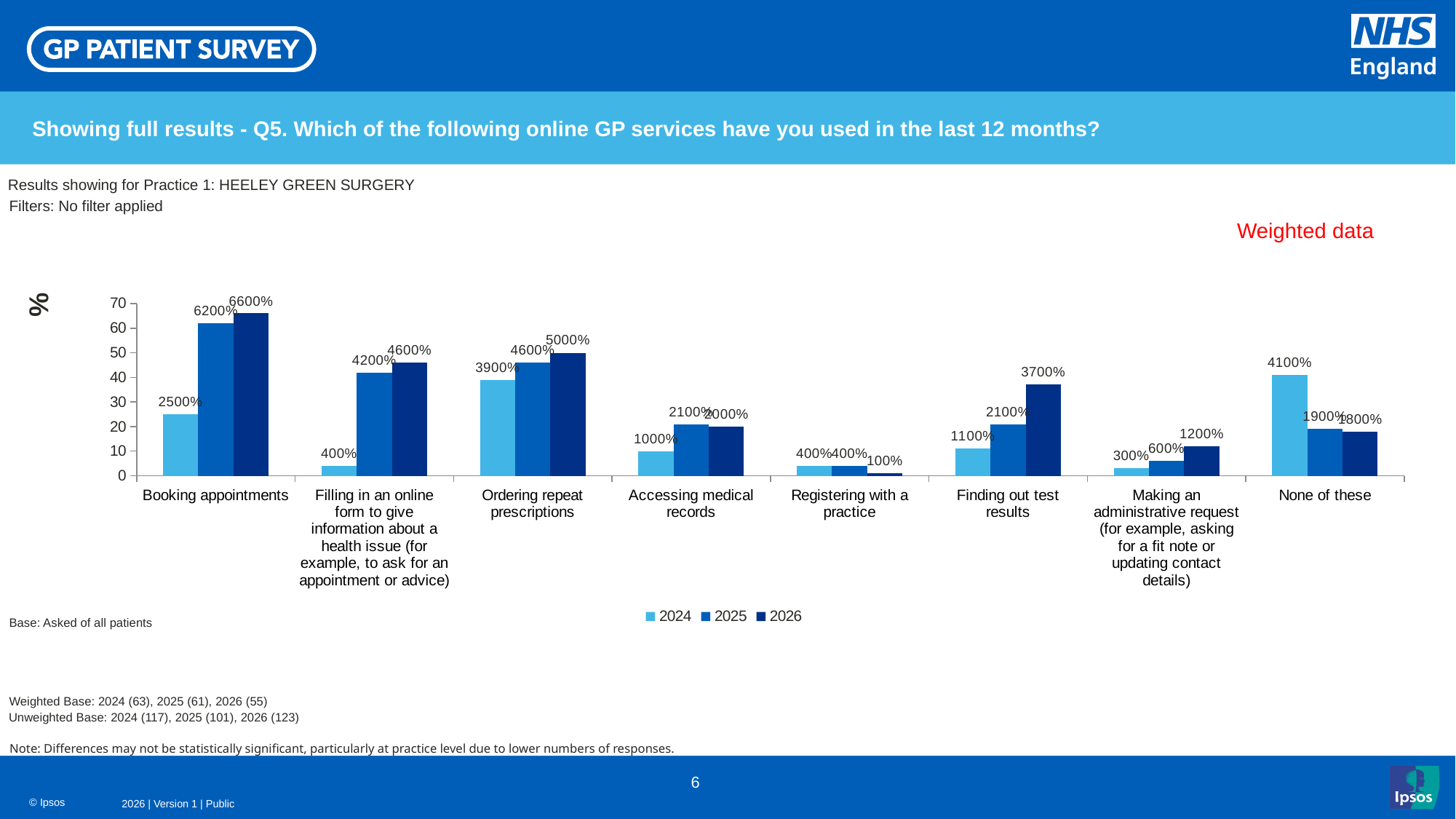
What is the data label for 2026 on the Booking appointments bar? 6600% How many categories are shown on the x axis? 8 Which is larger for None of these: the 2024 value or the 2025 value? 2024 What kind of chart is shown on the slide? bar chart What is the data label for 2024 on the Ordering repeat prescriptions bar? 3900% Is the 2024 bar for Booking appointments greater or less than 30 on the axis? less Do the values for Finding out test results rise or fall from 2024 to 2026? rise Which category has the highest 2026 value? Booking appointments Which category has the lowest 2026 value? Registering with a practice What is the data label for 2025 on the Finding out test results bar? 2100% How many series does the legend list? 3 What is the difference between the 2026 and 2024 data labels for Booking appointments? 4100%